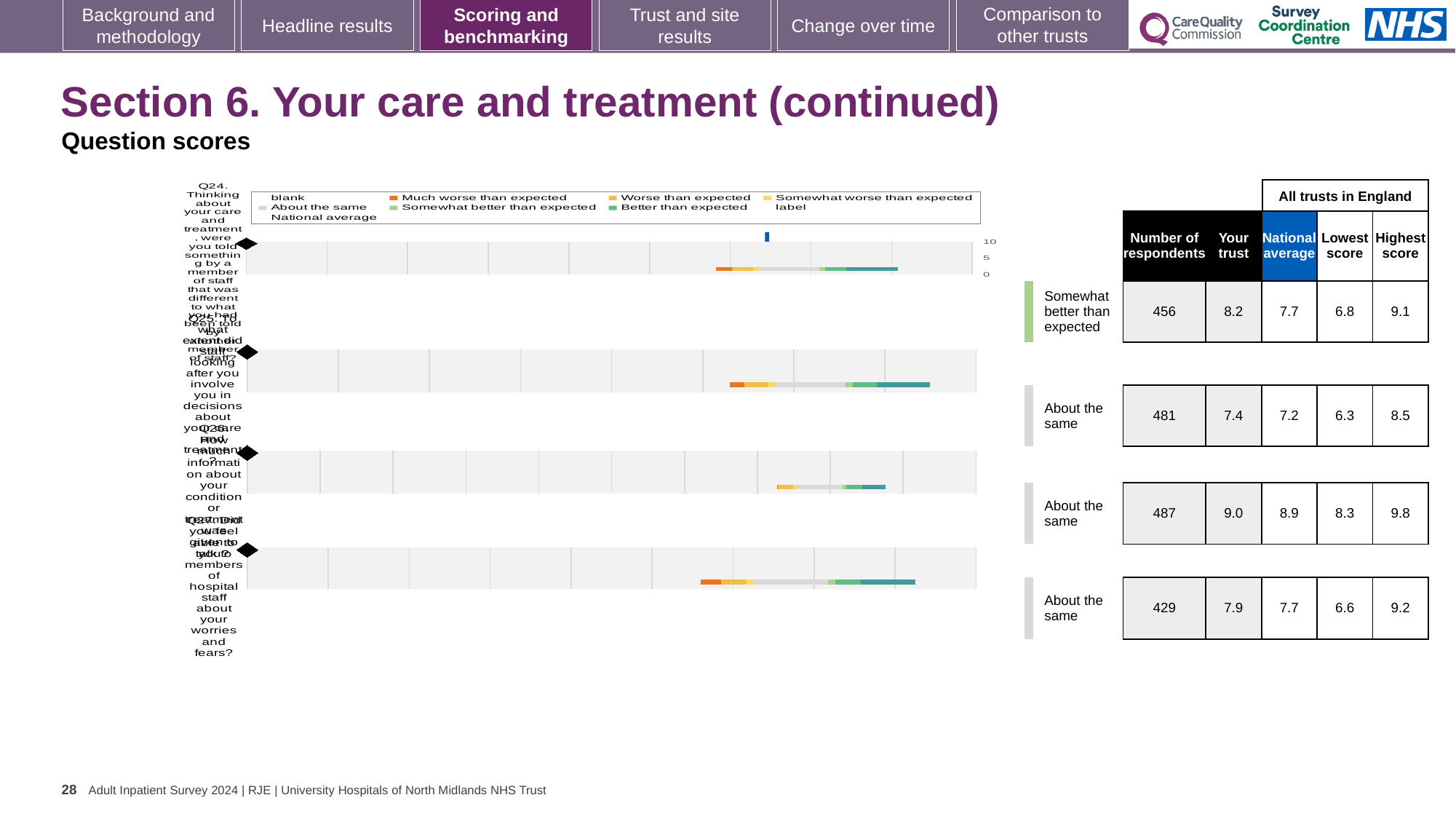
In the table beside the chart, what is the number of respondents for the second row (Q25)? 481 Which has the larger 'Your trust' score, the first row (Q24) or the fourth row (Q27)? Q24 What kind of chart is shown on the slide? bar chart In the table beside the chart, what is the national average for the third row (Q26)? 8.9 How many question rows (Q24 to Q27) does the chart show? 4 Which question row has the lowest 'Your trust' score in the table beside the chart? Q25 Which question row has the highest 'Your trust' score in the table beside the chart? Q26 In the table beside the chart, what is the 'Your trust' score for the first row (Q24)? 8.2 In the table beside the chart, what is the highest score for the fourth row (Q27)? 9.2 Which benchmark category label is shown next to the first chart row (Q24)? Somewhat better than expected What is the highest tick value shown on the chart's score axis? 10 For the first row (Q24), what is the difference between the 'Your trust' score and the national average? 0.5